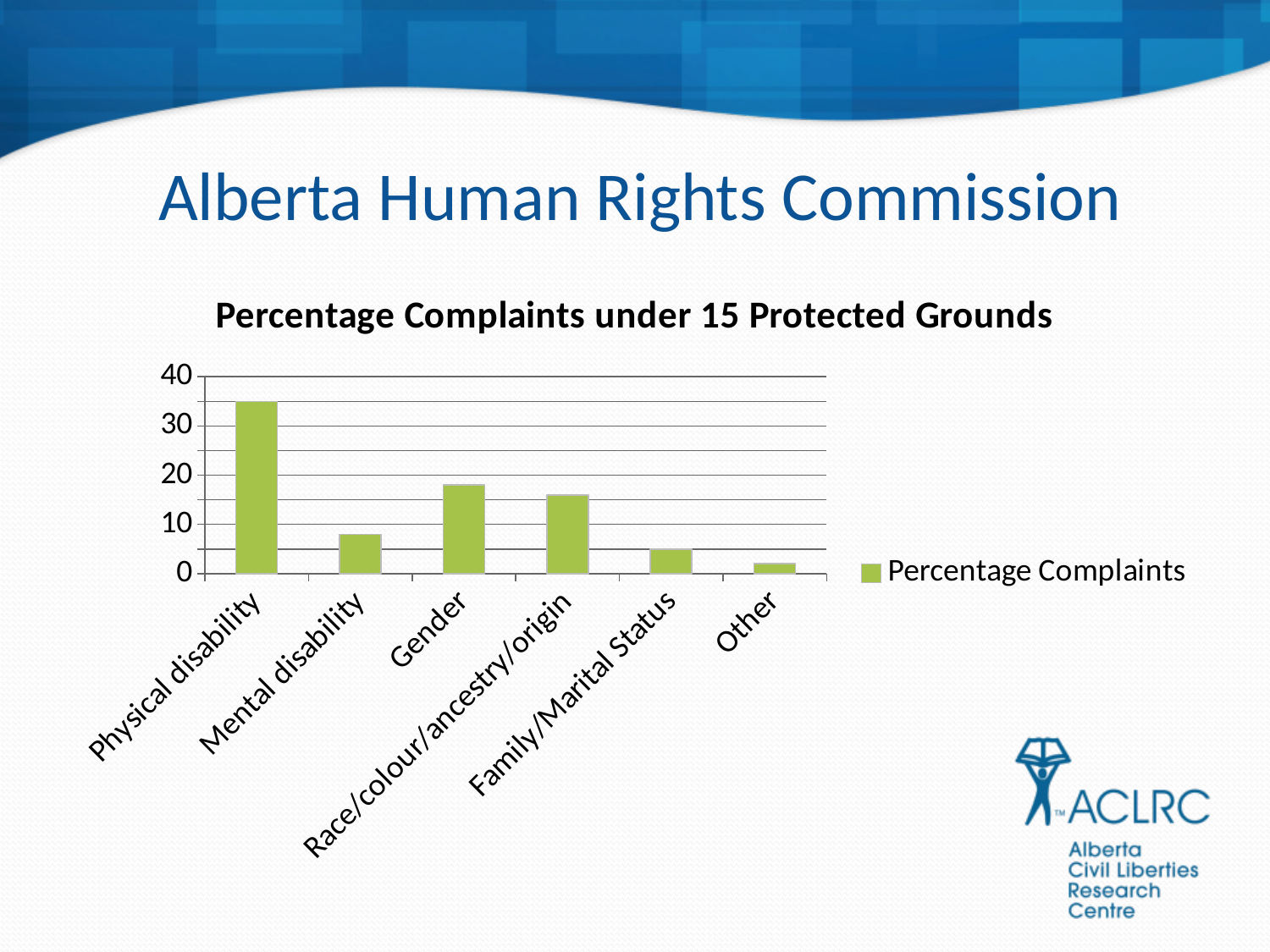
What is the title of the chart? Percentage Complaints under 15 Protected Grounds Which is larger, the value for Mental disability or the value for Family/Marital Status? Mental disability How many categories are shown on the x axis of the chart? 6 What type of chart is shown on the slide? bar chart Is the value for Physical disability greater or less than 30? greater Is the value for Race/colour/ancestry/origin greater or less than 20? less Is the value for Gender greater or less than 10? greater Which category has the highest percentage of complaints? Physical disability Which category has the lowest percentage of complaints? Other What is the name of the series shown in the legend? Percentage Complaints How many series does the chart legend list? 1